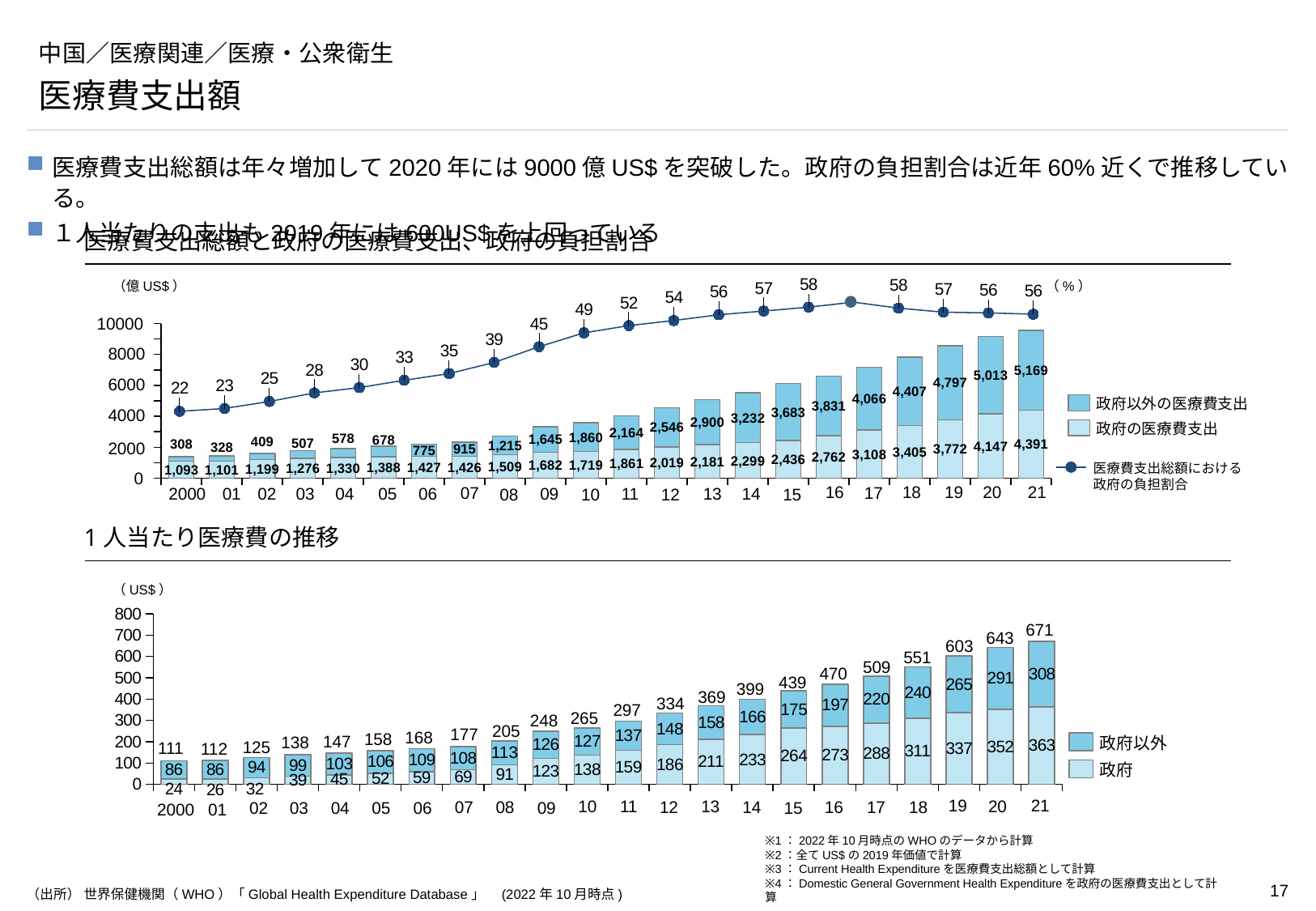
In the top chart, what is the value of 政府以外の医療費支出 for 2000? 308 In the top chart, what is the 政府の負担割合 (%) for 2000? 22 In the bottom chart, what is the difference between the 政府以外 value for 2021 and the 政府以外 value for 2000? 222 In the bottom chart, do the total per-capita values rise or fall from 2000 to 2021? rise In the top chart, how many series does the legend list? 3 In the bottom chart, how many years are shown on the x axis? 22 In the top chart (医療費支出総額と政府の医療費支出、政府の負担割合), what is the value of 政府の医療費支出 for 2021? 4,391 In the top chart, which year has the highest 政府以外の医療費支出? 2021 In the bottom chart, what is the 政府 value for 2010? 138 In the top chart, what is the total of the stacked bar for 2021 (政府の医療費支出 plus 政府以外の医療費支出)? 9,560 In the bottom chart, which year has the lowest total per-capita health expenditure? 2000 In the bottom chart (1人当たり医療費の推移), what is the total per-capita health expenditure for 2021? 671